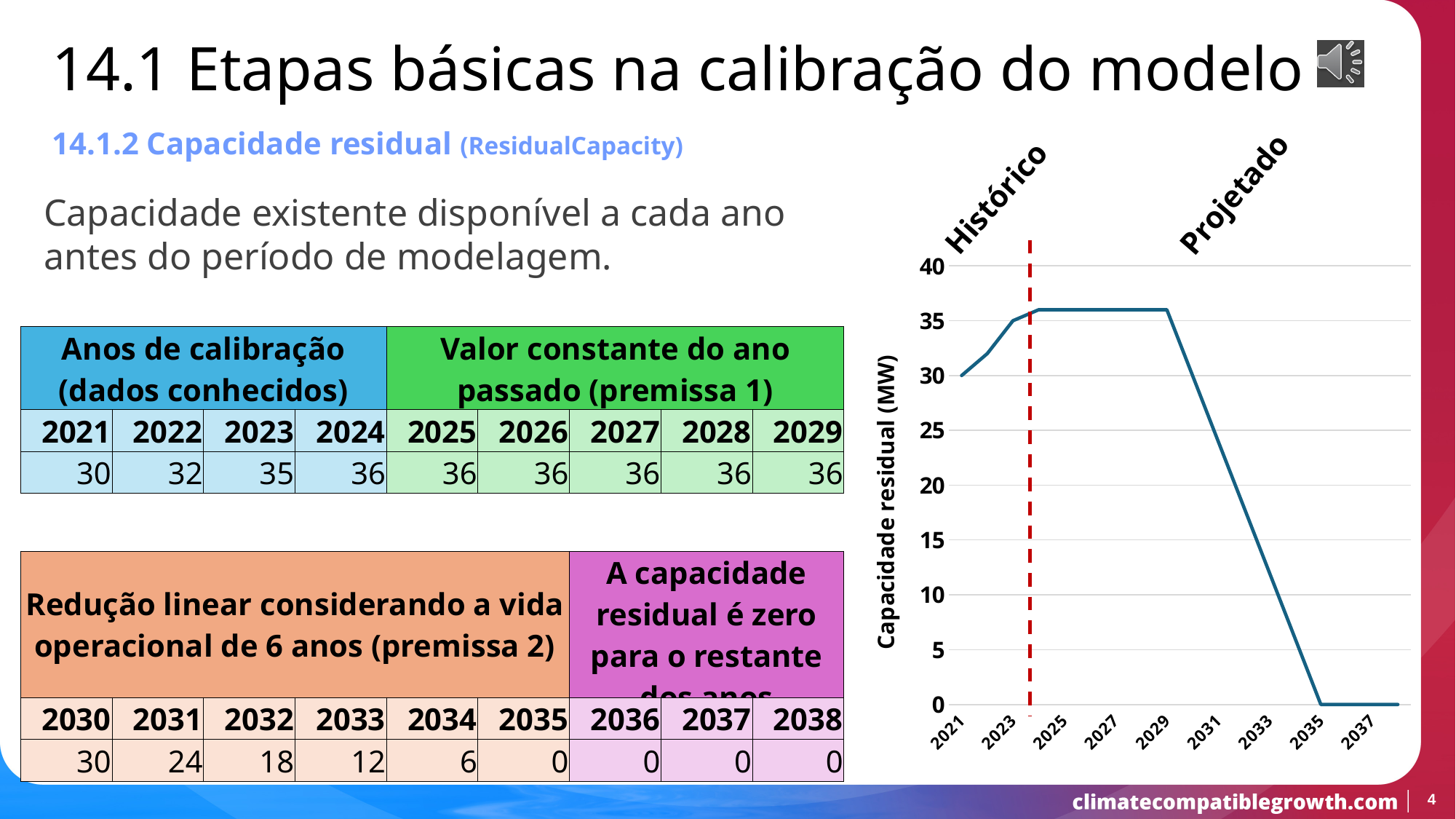
What are the two period labels written above the chart? Histórico and Projetado What kind of chart is shown on the right of the slide? line chart What is the residual capacity value for 2023 in the chart? 35 Does the line rise or fall between 2021 and 2024? rise What is the y-axis label of the chart? Capacidade residual (MW) Is the value for 2027 in the chart greater or less than 35? greater Is the value for 2033 in the chart greater or less than 15? less Does the line rise or fall between 2029 and 2035? fall What is the difference between the value for 2024 and the value for 2021 in the chart? 6 Which is larger in the chart, the value for 2025 or the value for 2031? 2025 What is the residual capacity value for 2035 in the chart? 0 What is the residual capacity value for 2021 in the chart? 30